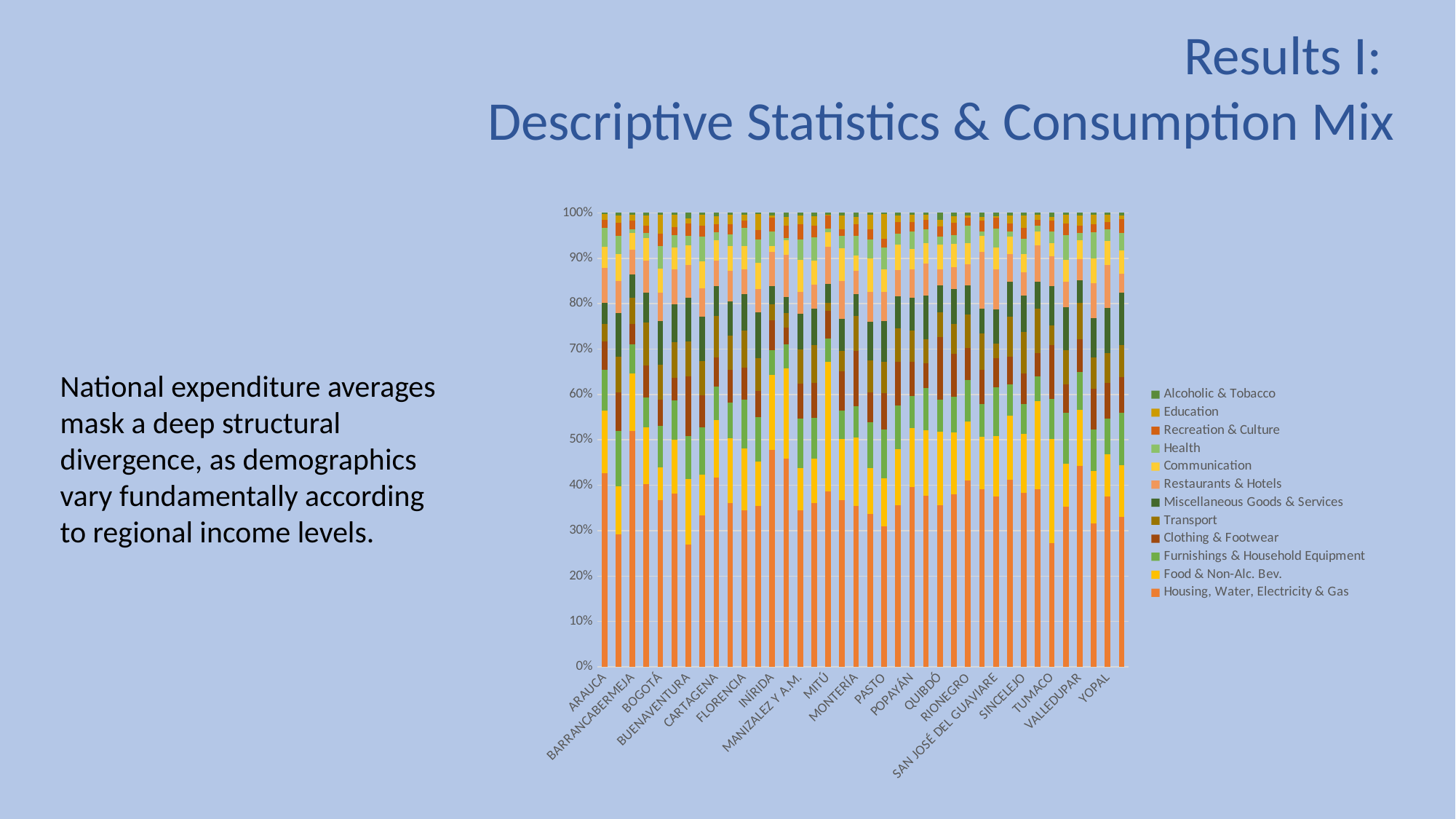
Which series forms the bottom segment of each stacked bar? Housing, Water, Electricity & Gas How many series does the legend list? 12 What kind of chart is shown on the slide? bar chart What is the highest value shown on the y axis? 100% Is the Housing, Water, Electricity & Gas value for ARAUCA greater or less than 30%? greater